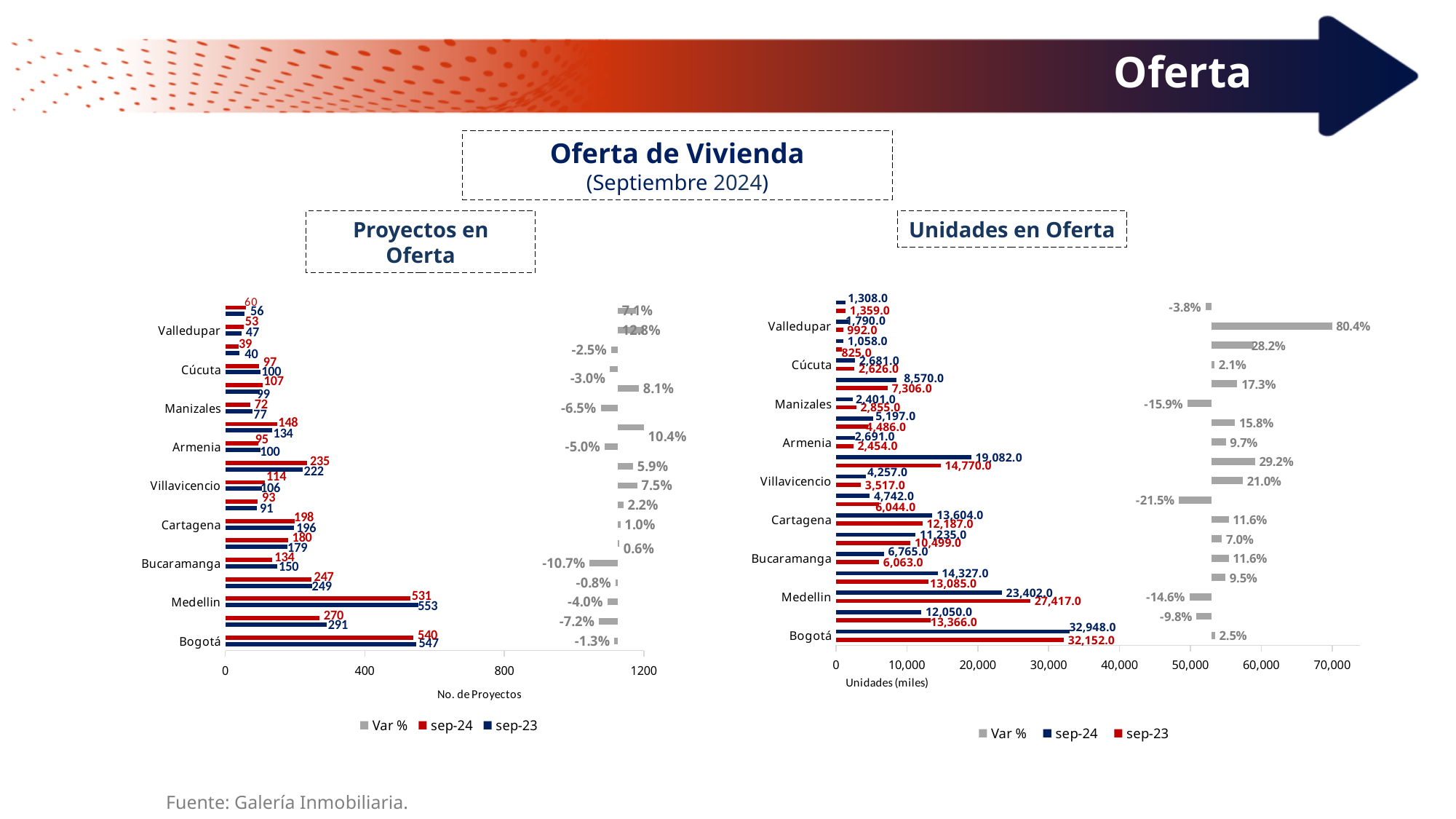
In the 'Unidades en Oferta' chart, which Var % value is the highest? 80.4% How many city labels appear on the y axis of the 'Proyectos en Oferta' chart? 9 In the 'Proyectos en Oferta' chart, for the Medellin bars labelled 531 and 553, which series is larger, sep-24 or sep-23? sep-23 In the 'Unidades en Oferta' chart, which Var % value is the lowest? -21.5% In the 'Proyectos en Oferta' chart, which Var % value is the lowest? -10.7% In the 'Unidades en Oferta' chart, what is the sep-24 value for the bar next to the Bogotá label? 32,948.0 In the 'Unidades en Oferta' chart, what is the difference between the sep-24 value (32,948.0) and the sep-23 value (32,152.0) for Bogotá? 796.0 In the 'Proyectos en Oferta' chart, what is the sep-24 value for the bar next to the Bogotá label? 540 In the 'Proyectos en Oferta' chart, what is the sep-23 value for the bar next to the Medellin label? 553 How many series does the legend of the 'Unidades en Oferta' chart list? 3 What kind of chart is the 'Proyectos en Oferta' chart? bar chart In the 'Unidades en Oferta' chart, what is the Var % shown next to the Valledupar label's top bar? 80.4%